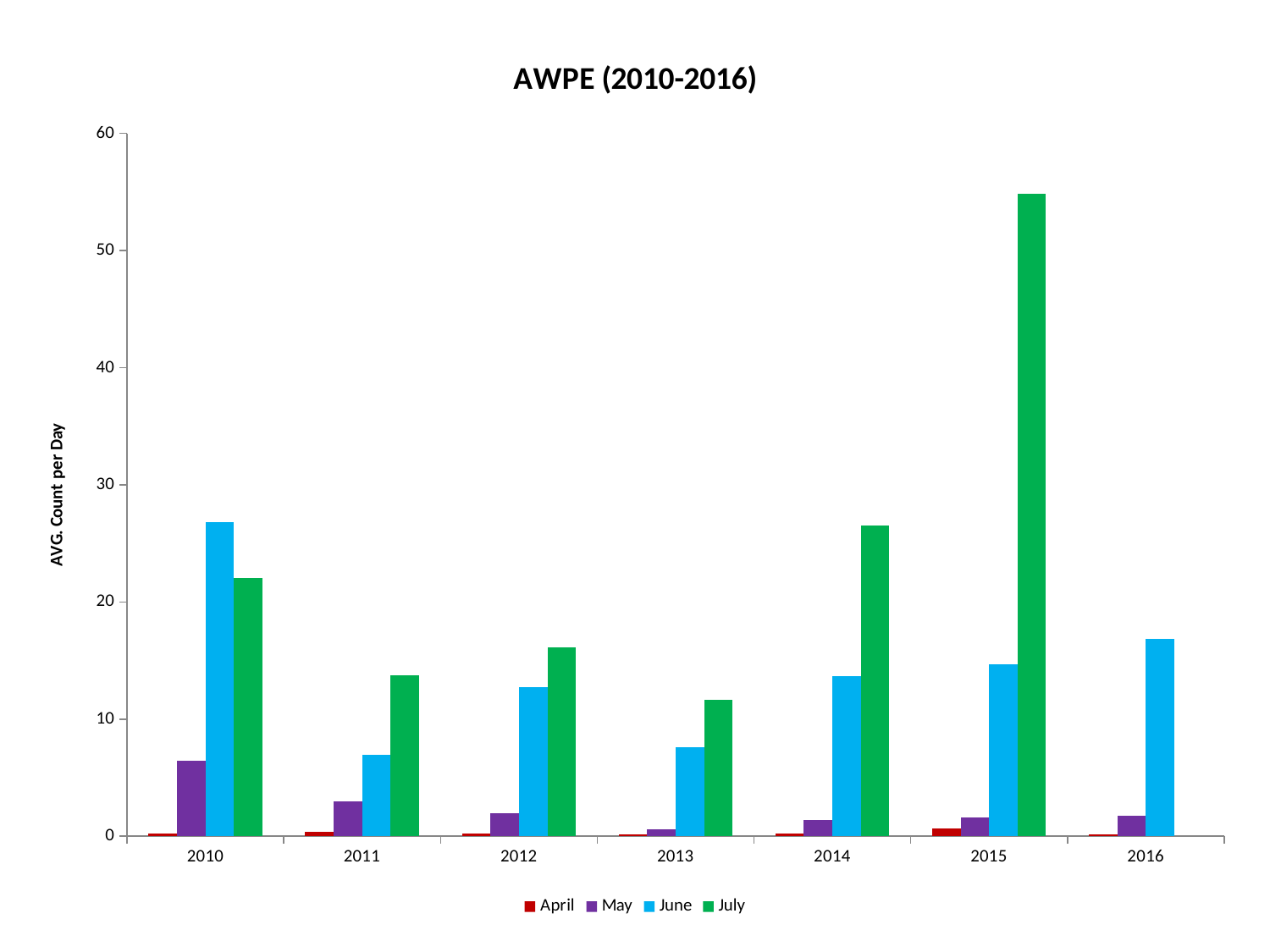
In 2014, which is larger, the June value or the July value? July Is the July value for 2015 greater or less than 50? greater Which year has the highest July bar? 2015 What kind of chart is shown on the slide? bar chart In 2010, which is larger, the June value or the July value? June Is the May value for 2010 greater or less than 10? less Which month has the highest bar in 2012? July What is the title of the chart? AWPE (2010-2016) Is the June value for 2010 greater or less than 20? greater How many years are shown on the x axis? 7 What is the label on the y axis? AVG. Count per Day How many series does the legend list? 4